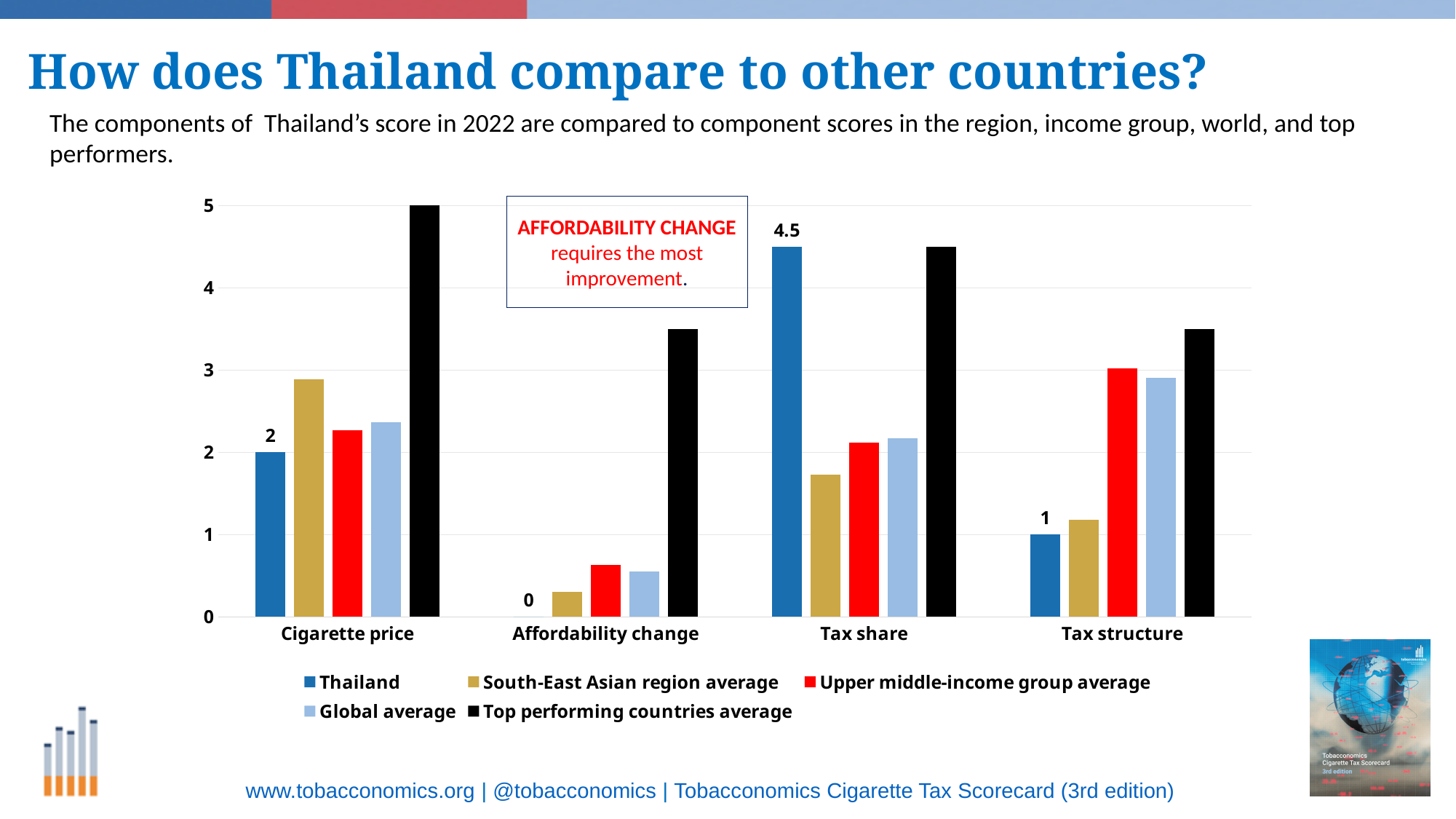
For Cigarette price, which is larger: Thailand's score or the South-East Asian region average? South-East Asian region average What is the difference between Thailand's Tax share score and its Cigarette price score? 2.5 How many components (categories) are shown on the x axis? 4 How many series does the legend list? 5 Is the Top performing countries average for Affordability change greater or less than 3? greater What is Thailand's score for Tax structure? 1 In which component does Thailand have its lowest score? Affordability change What kind of chart is shown on the slide? bar chart What is Thailand's score for Cigarette price? 2 What is Thailand's score for Affordability change? 0 What is Thailand's score for Tax share? 4.5 In which component does Thailand have its highest score? Tax share